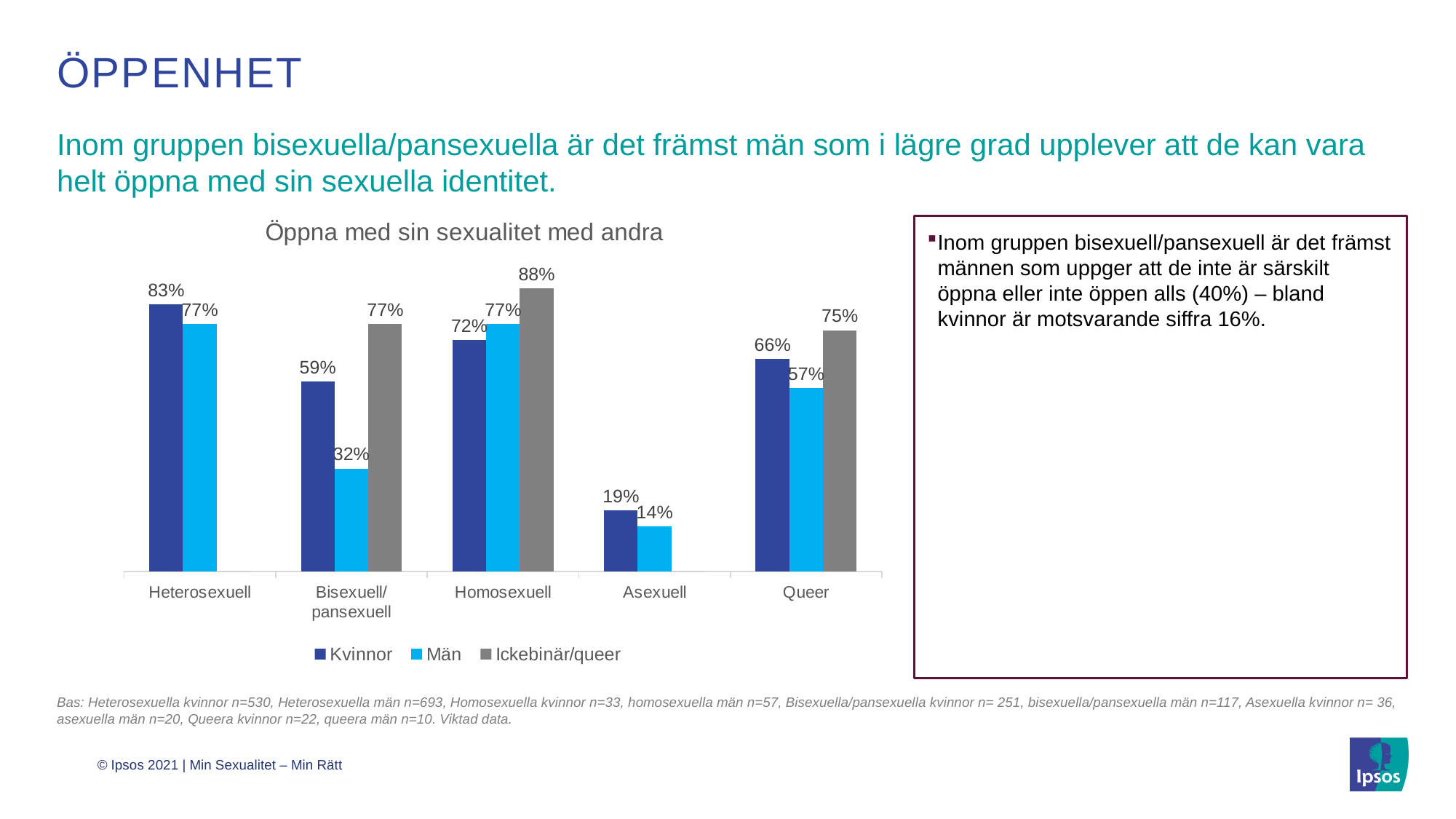
What is the title of the chart? Öppna med sin sexualitet med andra What is the difference between the Kvinnor and Män values in the Bisexuell/pansexuell category? 27 percentage points What kind of chart is shown on the slide? Bar chart What is the value for Män in the Asexuell category? 14% Which category has the lowest value for Män? Asexuell In the Queer category, which is larger: the value for Kvinnor or the value for Män? Kvinnor How many categories are shown on the x axis? 5 Which category has the highest value for Kvinnor? Heterosexuell What is the value for Kvinnor in the Heterosexuell category? 83% How many series does the legend list? 3 What is the value for Ickebinär/queer in the Homosexuell category? 88% What is the value for Män in the Bisexuell/pansexuell category? 32%